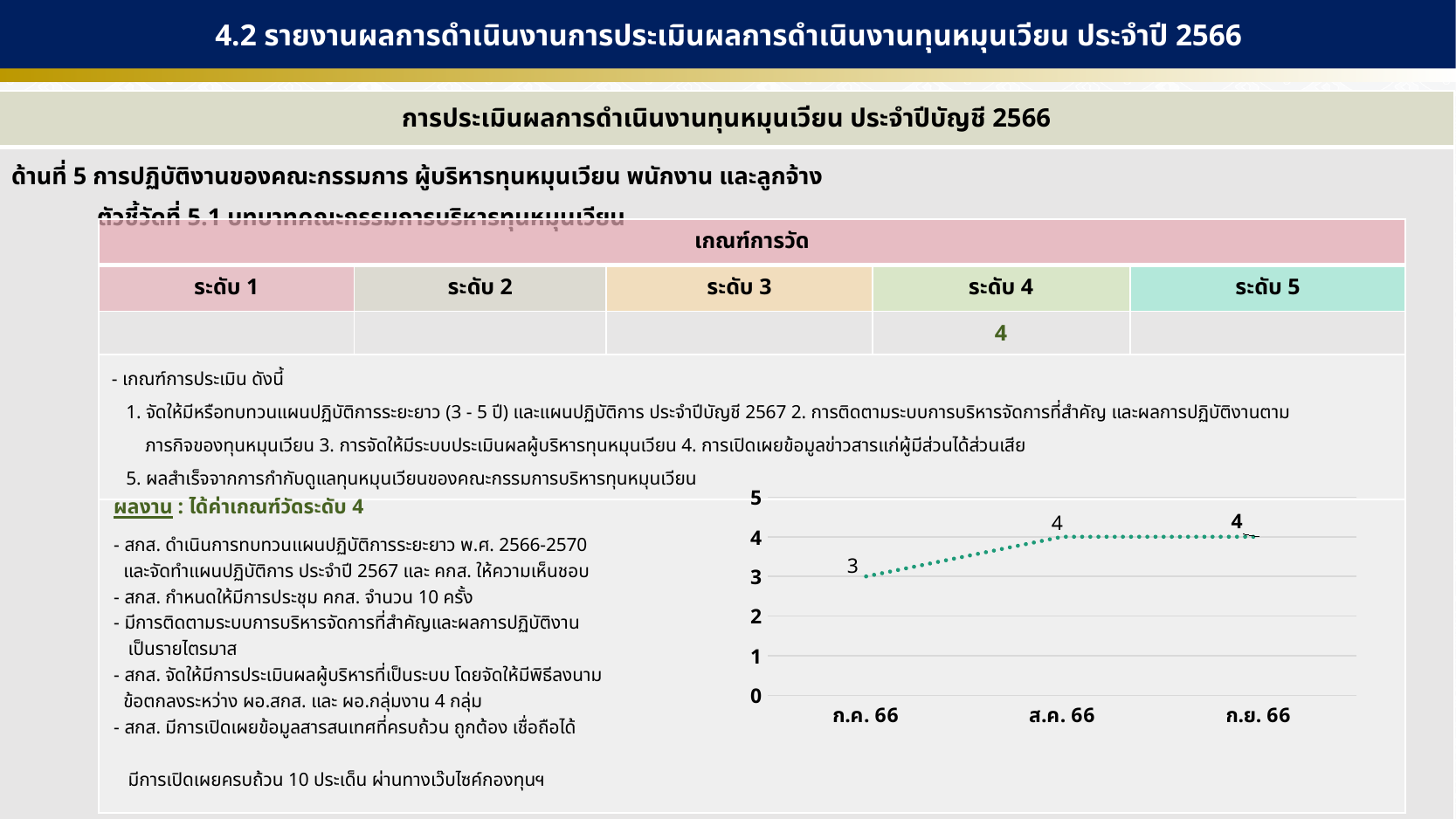
Is the value for ก.ค. 66 greater or less than 4? less How many data points are plotted in the line chart? 3 Do the values rise or fall from ก.ค. 66 to ส.ค. 66? rise What is the label of the last category on the x axis of the chart? ก.ย. 66 Which month has the lowest value in the line chart? ก.ค. 66 What is the difference between the values for ส.ค. 66 and ก.ค. 66? 1 Which is larger, the value for ก.ค. 66 or the value for ก.ย. 66? ก.ย. 66 What is the value for ก.ค. 66 in the line chart? 3 What kind of chart is shown on the slide? line chart What is the highest value shown on the y axis of the chart? 5 What is the value for ส.ค. 66 in the line chart? 4 What is the value for ก.ย. 66 in the line chart? 4